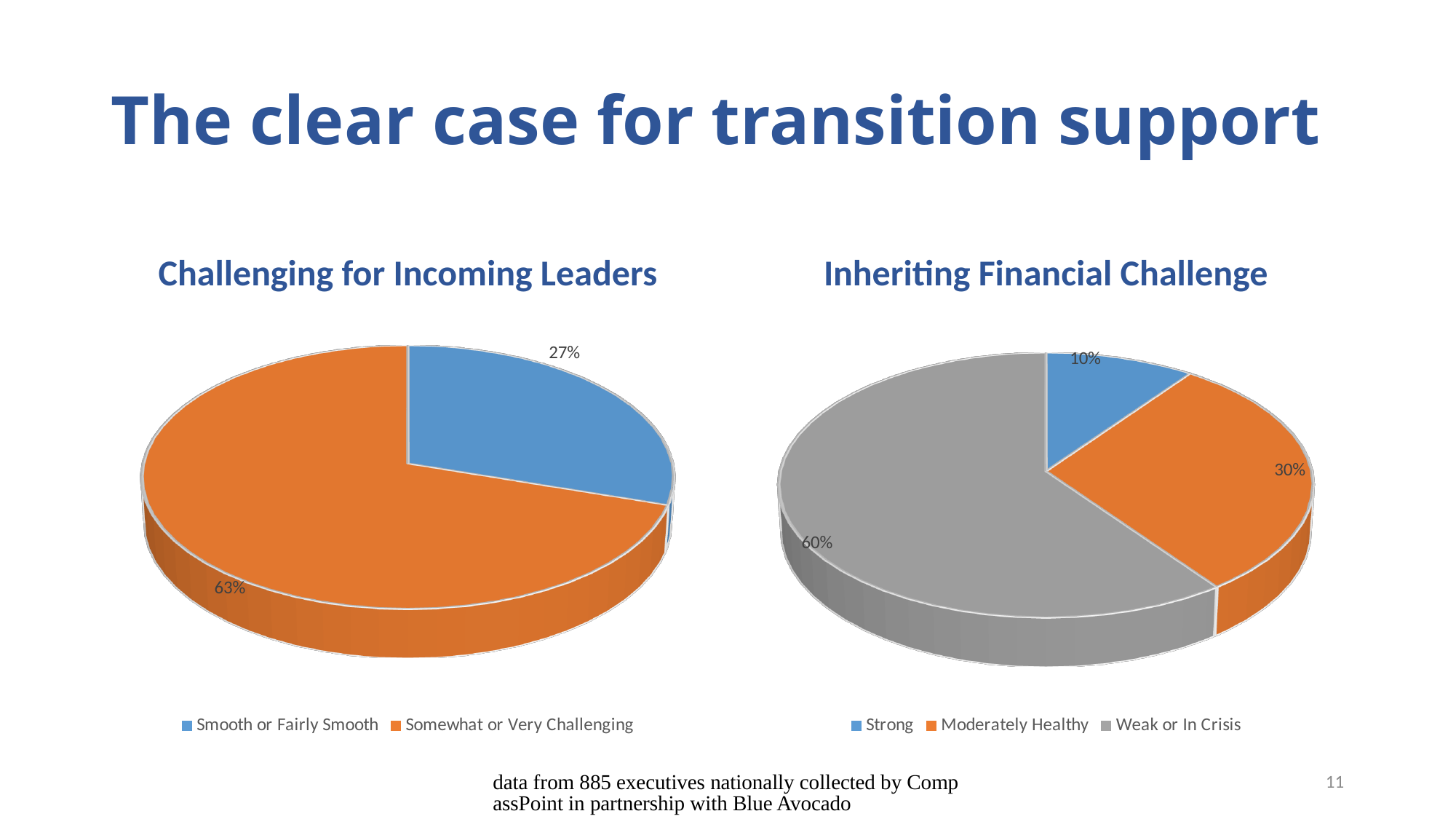
In the 'Inheriting Financial Challenge' chart, what is the difference between the 'Weak or In Crisis' and 'Moderately Healthy' percentages? 30% In the 'Challenging for Incoming Leaders' chart, which is larger: 'Smooth or Fairly Smooth' or 'Somewhat or Very Challenging'? Somewhat or Very Challenging In the 'Inheriting Financial Challenge' chart, which category has the smallest slice? Strong In the 'Challenging for Incoming Leaders' chart, what is the difference between the 'Somewhat or Very Challenging' and 'Smooth or Fairly Smooth' percentages? 36% In the 'Inheriting Financial Challenge' chart, what percentage is shown for 'Weak or In Crisis'? 60% In the 'Challenging for Incoming Leaders' chart, what percentage is shown for 'Smooth or Fairly Smooth'? 27% What type of chart is the 'Challenging for Incoming Leaders' chart? Pie chart In the 'Challenging for Incoming Leaders' chart, what percentage is shown for 'Somewhat or Very Challenging'? 63% In the 'Inheriting Financial Challenge' chart, which category has the largest slice? Weak or In Crisis In the 'Inheriting Financial Challenge' chart, what percentage is shown for 'Moderately Healthy'? 30% How many categories does the legend of the 'Inheriting Financial Challenge' chart list? 3 In the 'Inheriting Financial Challenge' chart, what percentage is shown for 'Strong'? 10%